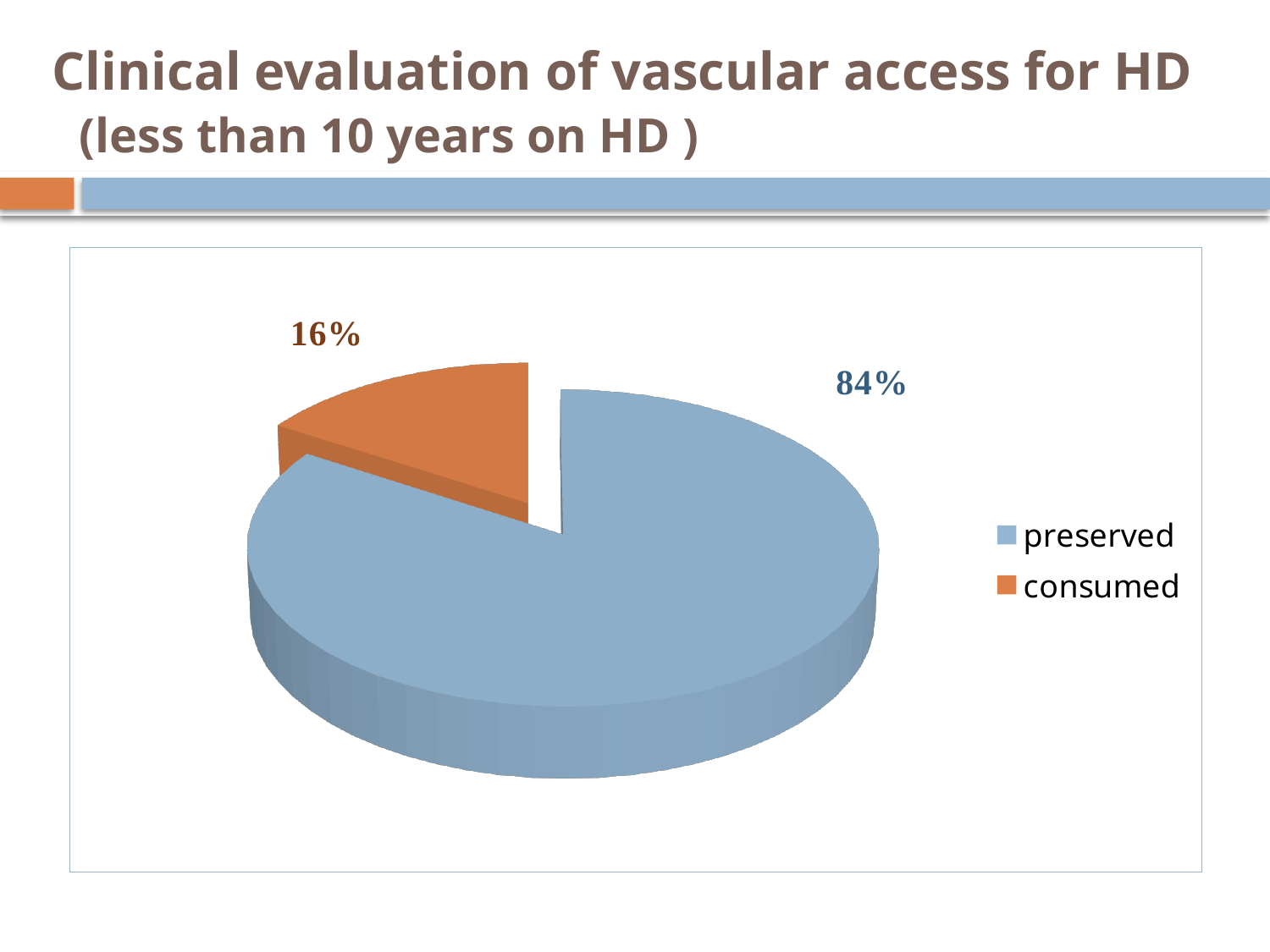
What percentage of the pie is labelled 'consumed'? 16% What colour is the 'consumed' slice? orange Which slice is larger, 'preserved' or 'consumed'? preserved How many slices does the pie chart have? 2 What kind of chart is shown on the slide? pie chart Which category has the smallest share of the pie? consumed Which category has the largest share of the pie? preserved What is the difference in percentage points between the 'preserved' and 'consumed' slices? 68 What share of the pie does the 'consumed' slice represent? 16% How many entries does the legend list? 2 What percentage of the pie is labelled 'preserved'? 84% Which slice is pulled out from the rest of the pie? consumed